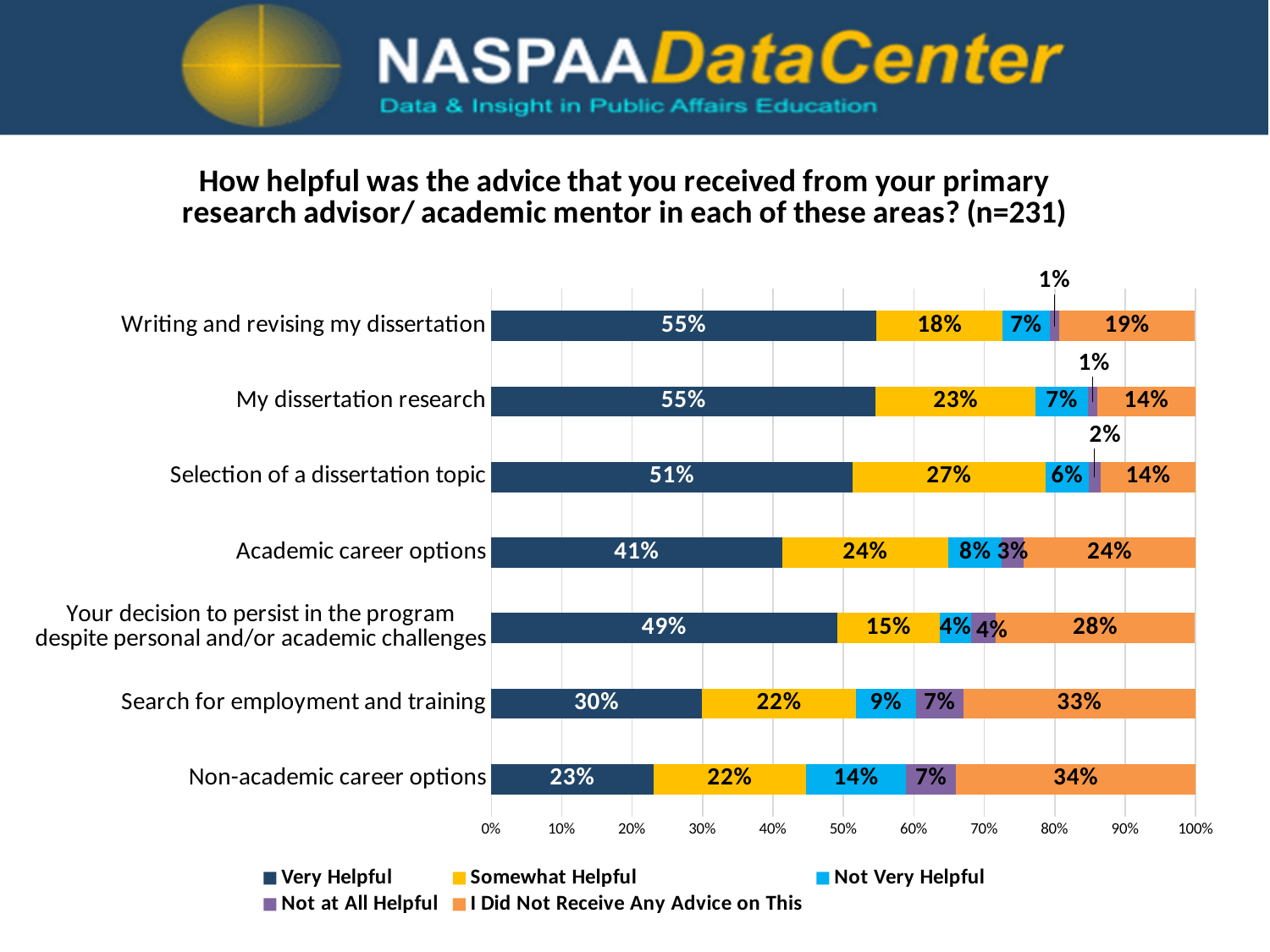
What is the 'Not at All Helpful' value for 'Search for employment and training'? 7% Which has a larger 'Somewhat Helpful' value: 'Academic career options' or 'Search for employment and training'? Academic career options What percentage of respondents found advice on 'Writing and revising my dissertation' Very Helpful? 55% What kind of chart is shown on the slide? Stacked bar chart What is the 'I Did Not Receive Any Advice on This' value for 'Non-academic career options'? 34% What is the difference between the 'Very Helpful' values for 'Writing and revising my dissertation' and 'Non-academic career options'? 32 percentage points Which category has the highest 'Somewhat Helpful' percentage? Selection of a dissertation topic What is the 'Somewhat Helpful' value for 'Selection of a dissertation topic'? 27% Which legend entry is shown in orange? I Did Not Receive Any Advice on This How many categories (areas of advice) are plotted on the chart? 7 Which category has the lowest 'Very Helpful' percentage? Non-academic career options How many series does the legend list? 5